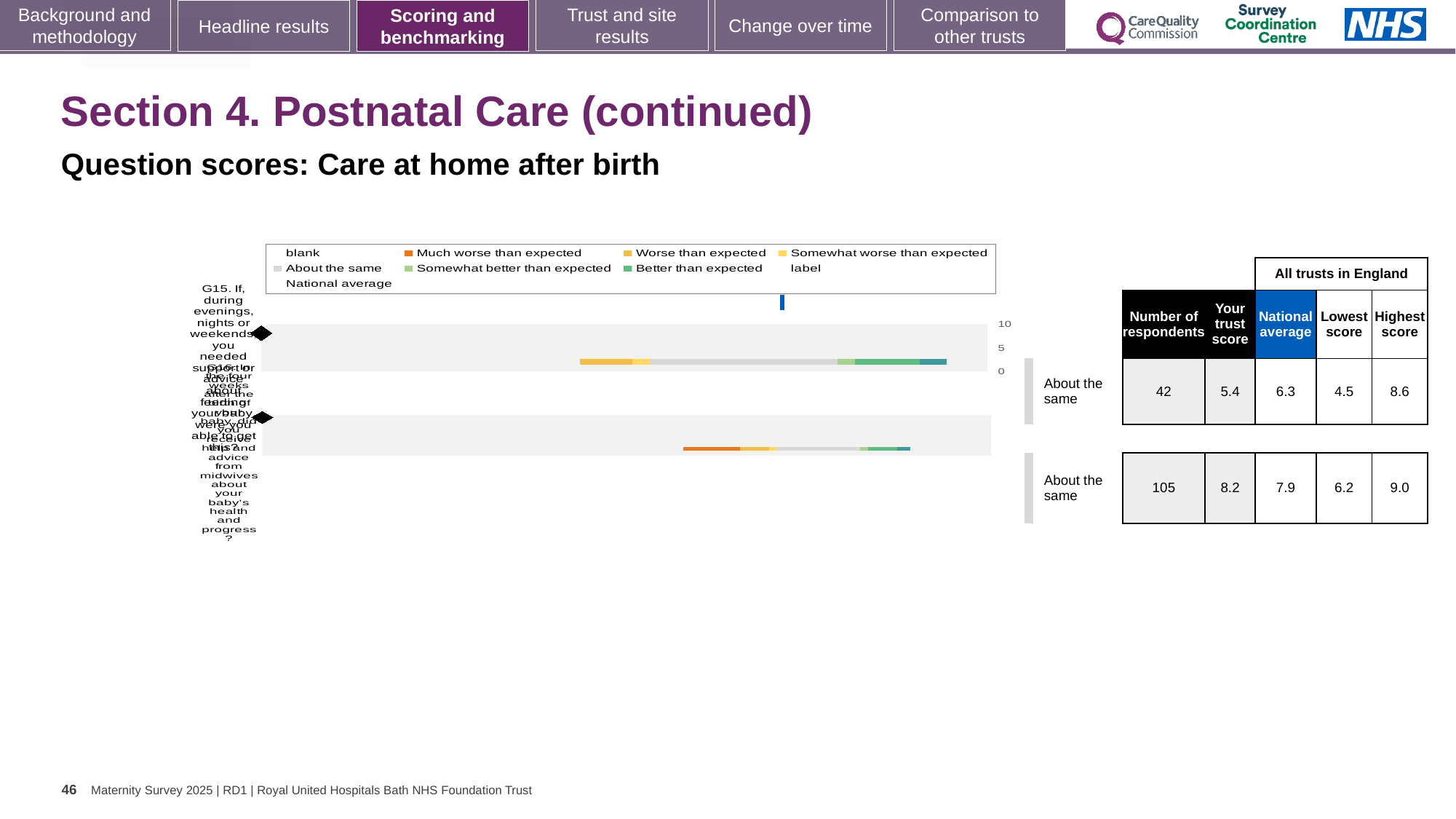
Which row has more respondents, the first (G15) or the second? the second row How many entries does the chart legend list? 9 What is the highest tick value shown on the chart's score axis? 10 What benchmark category is shown for both rows of the chart? About the same What is the difference in number of respondents between the second row and the first row (G15)? 63 For the first row (G15), what is the difference between the highest score and the lowest score? 4.1 What kind of chart is shown on the slide? bar chart What is 'Your trust score' for the first row (G15) in the table beside the chart? 5.4 What is the number of respondents for the first row (G15)? 42 What is the 'National average' for the second row in the table beside the chart? 7.9 What colour does the legend use for 'Much worse than expected'? orange How many question rows (bars) are plotted in the chart? 2